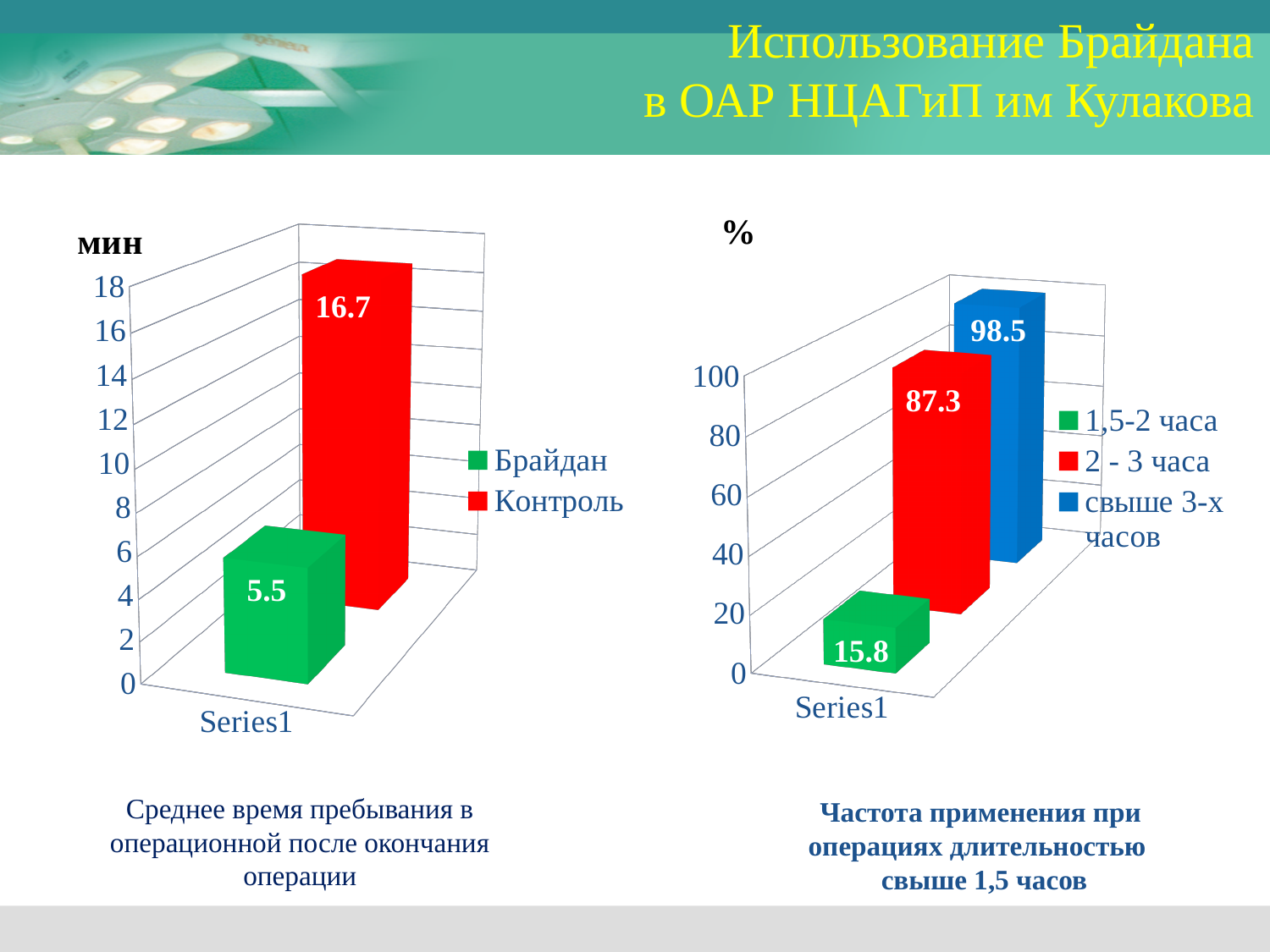
On the right chart, which category has the lowest value? 1,5-2 часа On the left chart, what is the value for Контроль? 16.7 On the right chart, which category has the highest value? свыше 3-х часов On the right chart, what is the value for 2 - 3 часа? 87.3 On the left chart, what is the difference between Контроль and Брайдан? 11.2 On the right chart, what is the value for 1,5-2 часа? 15.8 On the left chart, which is larger, Брайдан or Контроль? Контроль What kind of chart is the left chart? bar chart On the left chart, how many series does the legend list? 2 On the right chart, how many series does the legend list? 3 On the left chart, what is the value for Брайдан? 5.5 On the right chart, what is the value for свыше 3-х часов? 98.5